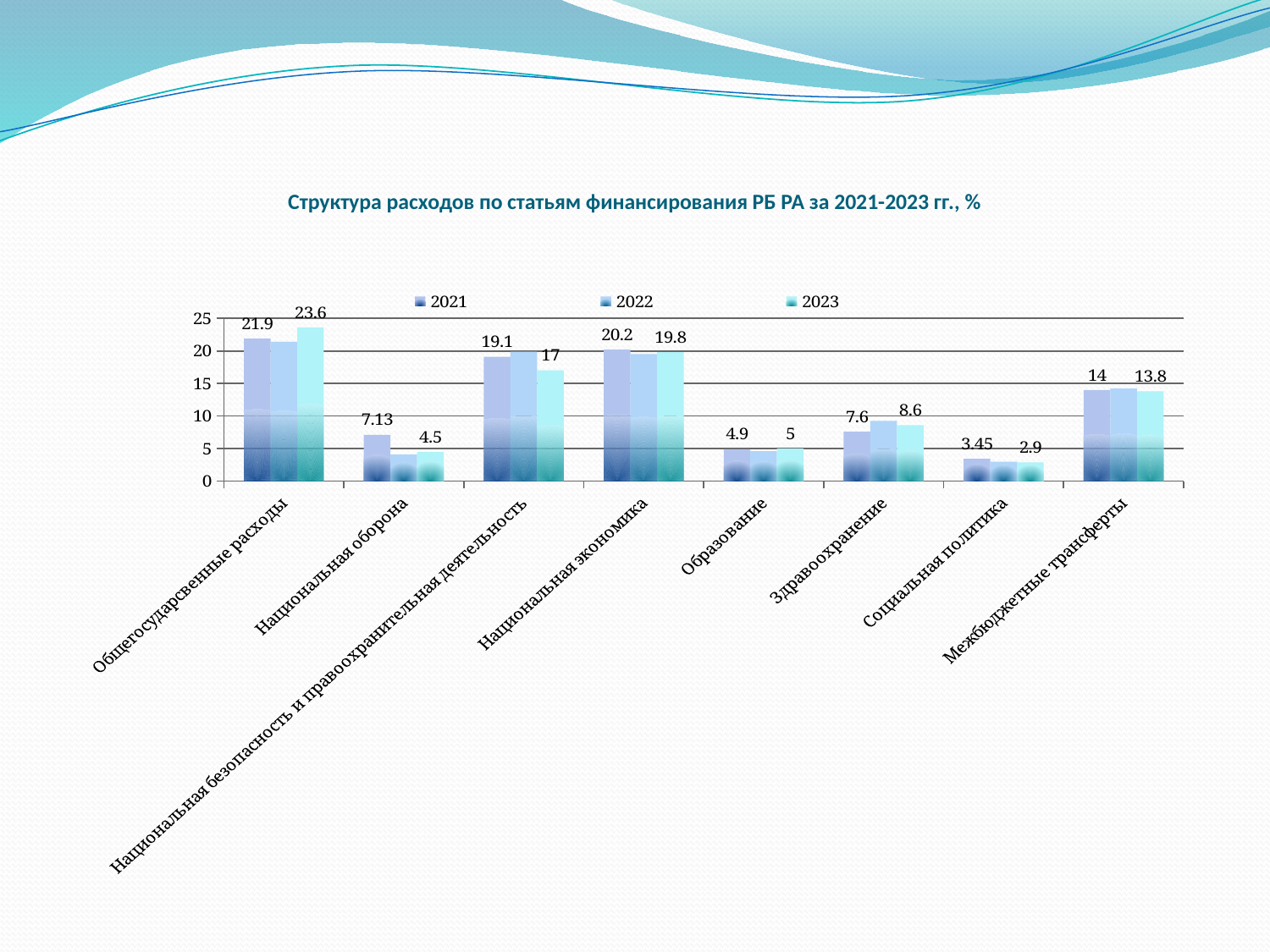
How many series does the legend list? 3 Is the 2022 value for Национальная оборона greater or less than 5? less What is the 2023 value for Здравоохранение? 8.6 What kind of chart is shown on the slide? bar chart How many expenditure categories are shown on the x axis? 8 Does the value for Национальная оборона rise or fall from 2021 to 2023? fall What is the difference between the 2023 and 2021 values for Общегосударственные расходы? 1.7 What is the 2021 value for Общегосударственные расходы? 21.9 Which category has the highest 2023 value? Общегосударственные расходы Which is larger for Национальная экономика: the 2021 value or the 2023 value? 2021 Which category has the lowest 2021 value? Социальная политика What is the 2021 value for Социальная политика? 3.45